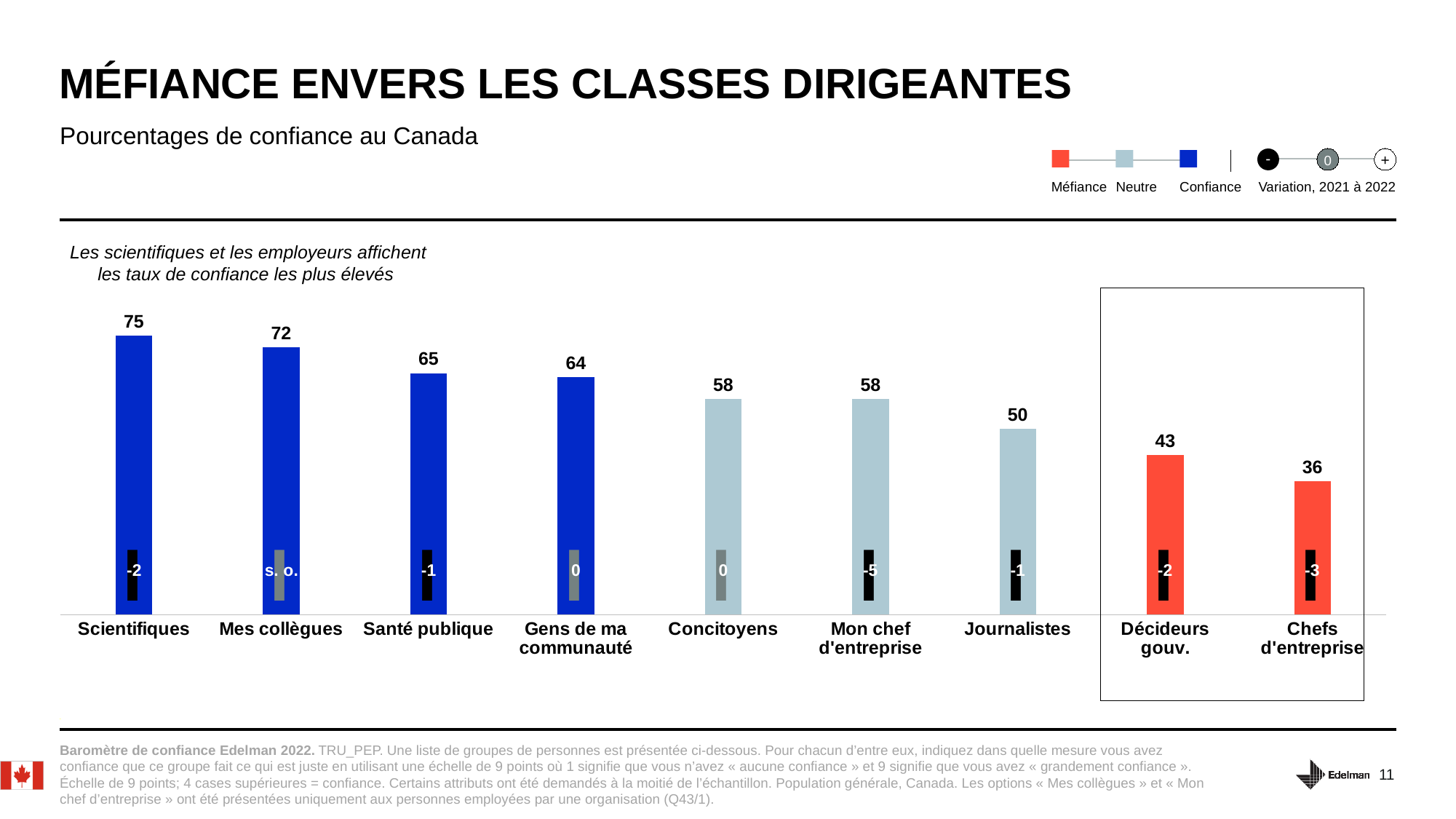
What is the trust percentage for Journalistes? 50 How many categories are shown on the chart? 9 What kind of chart is shown on the slide? Bar chart Which has a higher trust percentage, Mes collègues or Santé publique? Mes collègues Which colour does the legend assign to 'Méfiance'? Red Which category has the highest trust percentage? Scientifiques What is the trust percentage for Scientifiques? 75 What is the trust percentage for Chefs d'entreprise? 36 What is the difference between the trust percentages for Scientifiques and Chefs d'entreprise? 39 Which category has the lowest trust percentage? Chefs d'entreprise What is the difference between the trust percentages for Décideurs gouv. and Chefs d'entreprise? 7 What is the variation from 2021 to 2022 shown for Mon chef d'entreprise? -5